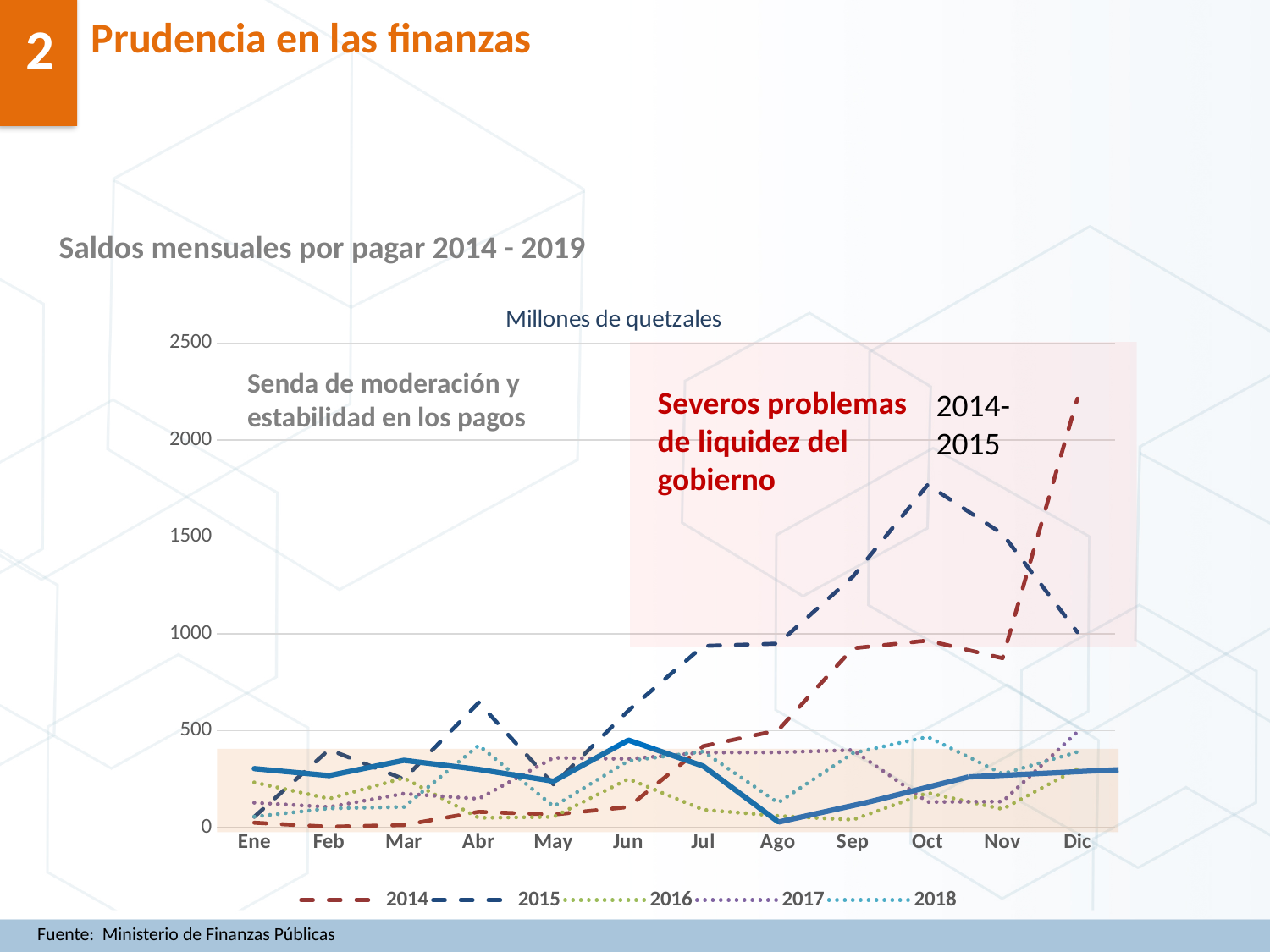
How many series does the chart legend list? 5 In Dic, which series has the larger value, 2014 or 2015? 2014 Is the value for 2014 in Ene greater or less than 500? less In which month does the 2014 series reach its highest value? Dic Is the value for 2014 in Dic greater or less than 2000? greater How many months are shown along the x axis of the chart? 12 Does the 2015 series rise or fall from Jun to Oct? rise What unit is stated above the chart for the values? Millones de quetzales What kind of chart is shown on the slide? line chart Is the value for 2015 in Jul greater or less than 500? greater In which month does the 2015 series reach its highest value? Oct